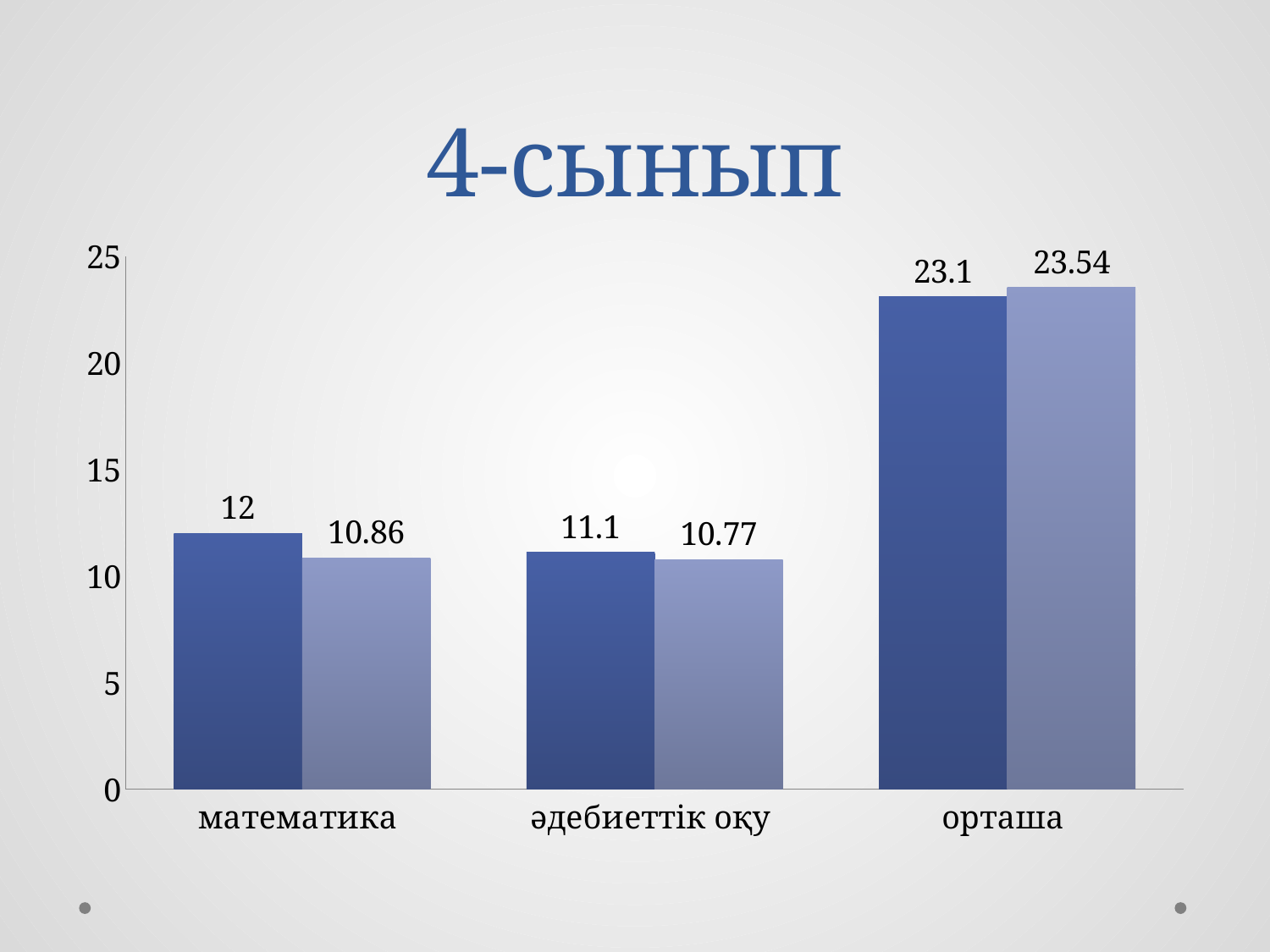
What type of chart is shown on the slide? bar chart What is the title of the slide? 4-сынып What is the value of the dark blue bar for әдебиеттік оқу? 11.1 What is the value of the light blue bar for орташа? 23.54 Which category has the lowest light blue bar? әдебиеттік оқу Which category has the highest dark blue bar? орташа How many categories are shown on the x axis? 3 What is the value of the dark blue bar for математика? 12 What is the difference between the dark blue and light blue bars for математика? 1.14 For орташа, which bar is larger, the dark blue or the light blue? light blue What is the value of the light blue bar for әдебиеттік оқу? 10.77 What is the difference between the light blue bars for орташа and математика? 12.68